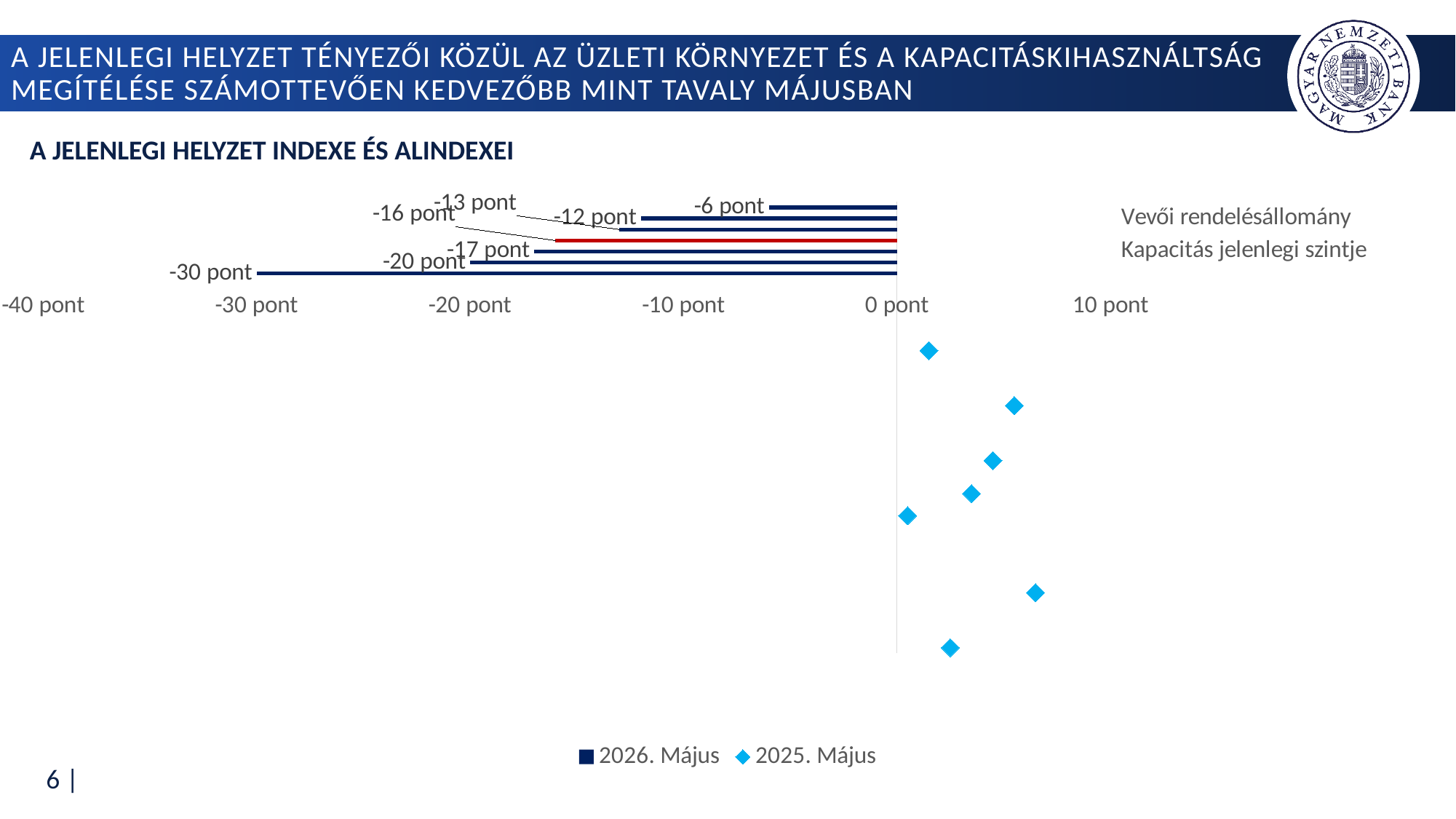
What are the two series named in the legend? 2026. Május and 2025. Május How many bars are plotted for the 2026. Május series? 7 Which is larger, the bar labelled -12 pont or the bar labelled -17 pont? -12 pont What is the difference between the highest labelled bar value (-6 pont) and the lowest (-30 pont)? 24 pont What kind of chart is shown on the slide? bar chart How many series does the legend list? 2 What is the title of the chart? A JELENLEGI HELYZET INDEXE ÉS ALINDEXEI Is the value of the longest 2026. Május bar greater or less than -20 pont? less What is the highest (least negative) value labelled on the 2026. Május bars? -6 pont What is the lowest value labelled on the 2026. Május bars? -30 pont What is the difference between the bars labelled -6 pont and -12 pont? 6 pont